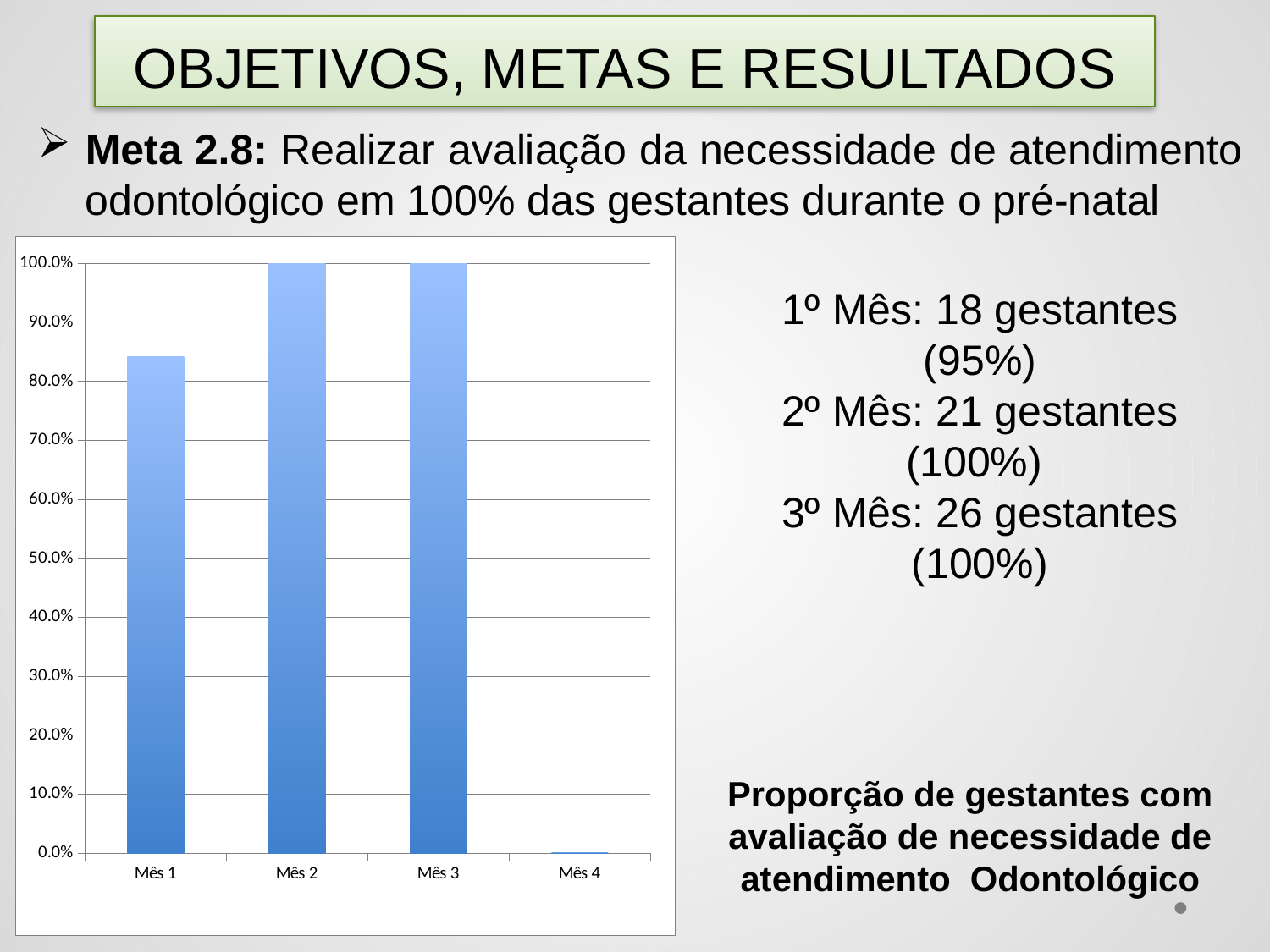
Is the value for Mês 1 greater or less than 80.0%? greater How many categories (months) are shown on the x axis of the chart? 4 Which month has the lowest value in the chart? Mês 4 Is the value for Mês 4 greater or less than 10.0%? less Which is larger, the value for Mês 1 or the value for Mês 2? Mês 2 What is the label of the first category on the x axis of the chart? Mês 1 What is the highest tick value shown on the y axis of the chart? 100.0% What kind of chart is shown on the slide? Bar chart Which is larger, the value for Mês 3 or the value for Mês 4? Mês 3 Is the value for Mês 1 greater or less than 90.0%? less What is the value for Mês 2 in the chart? 100.0% What is the value for Mês 3 in the chart? 100.0%